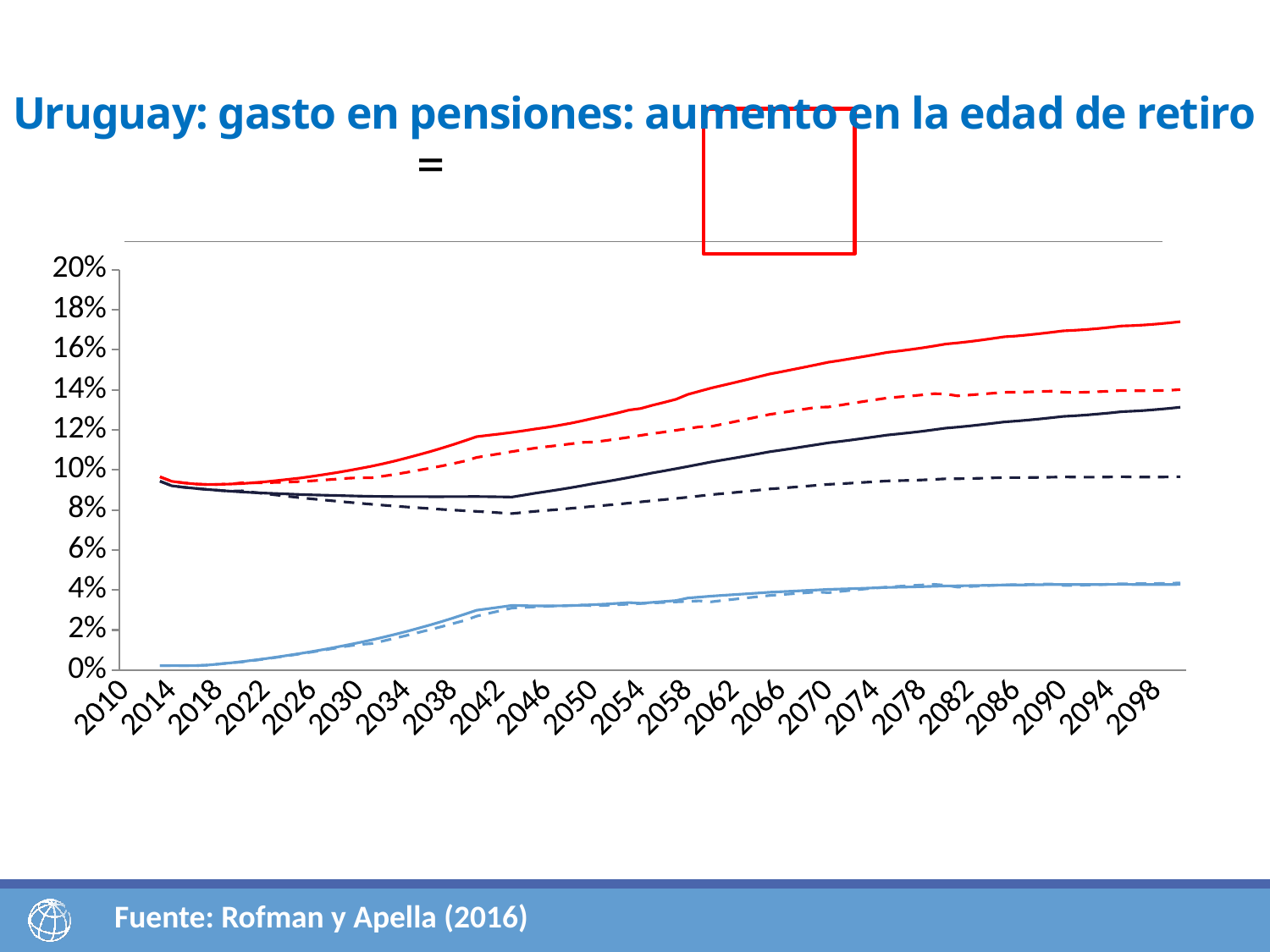
Is the value of the solid light blue line at 2014 greater or less than 2%? less How many year labels are shown on the x axis? 23 Is the value of the solid dark navy line at 2098 greater or less than 12%? greater At 2098, which is higher: the dashed red line or the solid dark navy line? the dashed red line Is the value of the solid red line at 2098 greater or less than 16%? greater Which line is the highest at 2098? the solid red line Does the solid red line rise or fall from 2014 to 2098? rise What kind of chart is shown on the slide? line chart What is the title of the chart on the slide? Uruguay: gasto en pensiones: aumento en la edad de retiro What source is cited at the bottom of the slide? Rofman y Apella (2016)